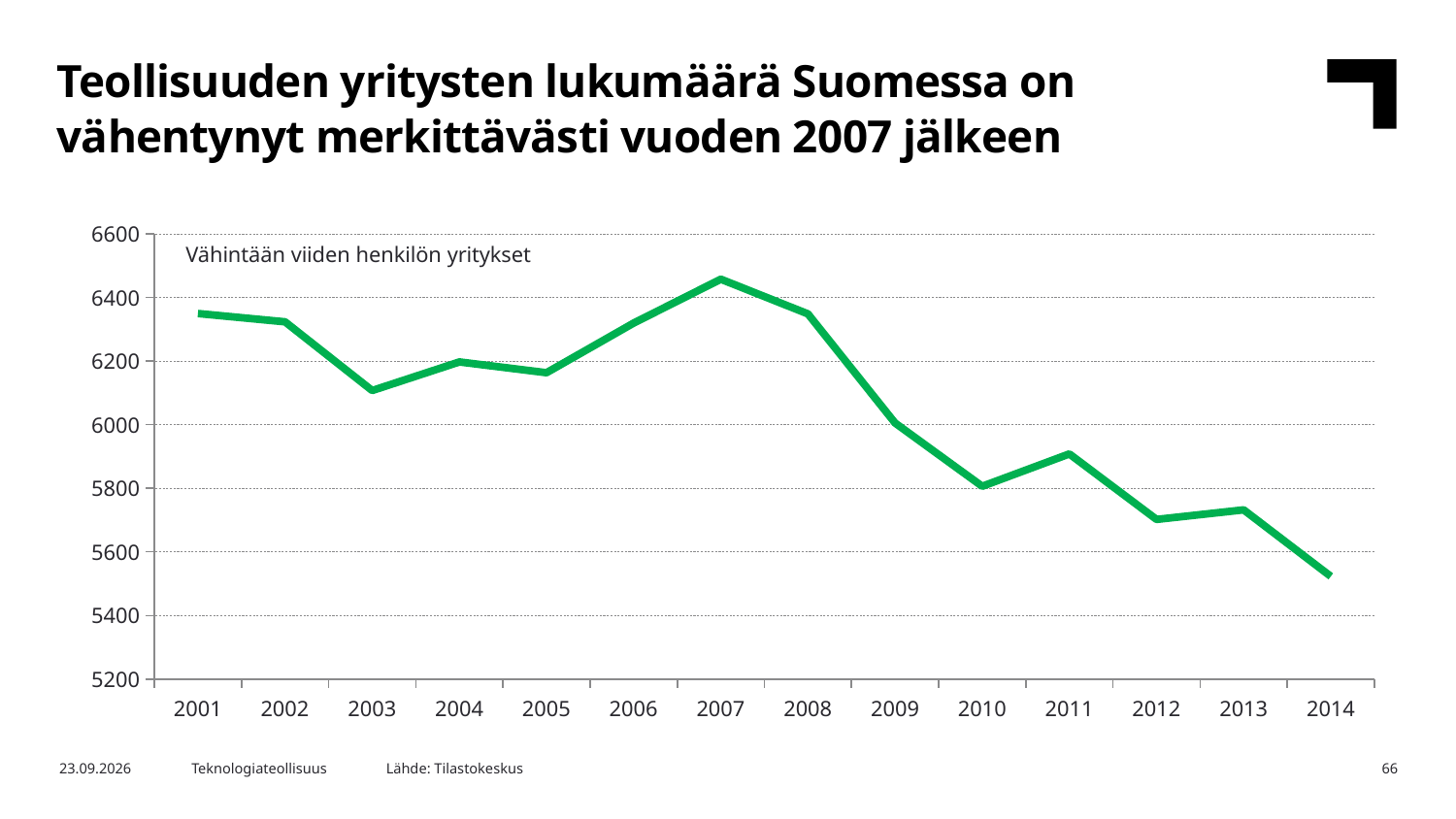
Is the value for 2007 greater or less than 6400? greater Which year has the larger value, 2003 or 2006? 2006 Is the value for 2012 greater or less than 5800? less Is the value for 2014 greater or less than 5600? less In which year is the number of companies highest? 2007 What source is cited for the chart data? Tilastokeskus In which year is the number of companies lowest? 2014 What kind of chart is shown on the slide? Line chart What text label is shown inside the plot area of the chart? Vähintään viiden henkilön yritykset Do the values rise or fall from 2007 to 2014? fall How many years are plotted on the x axis? 14